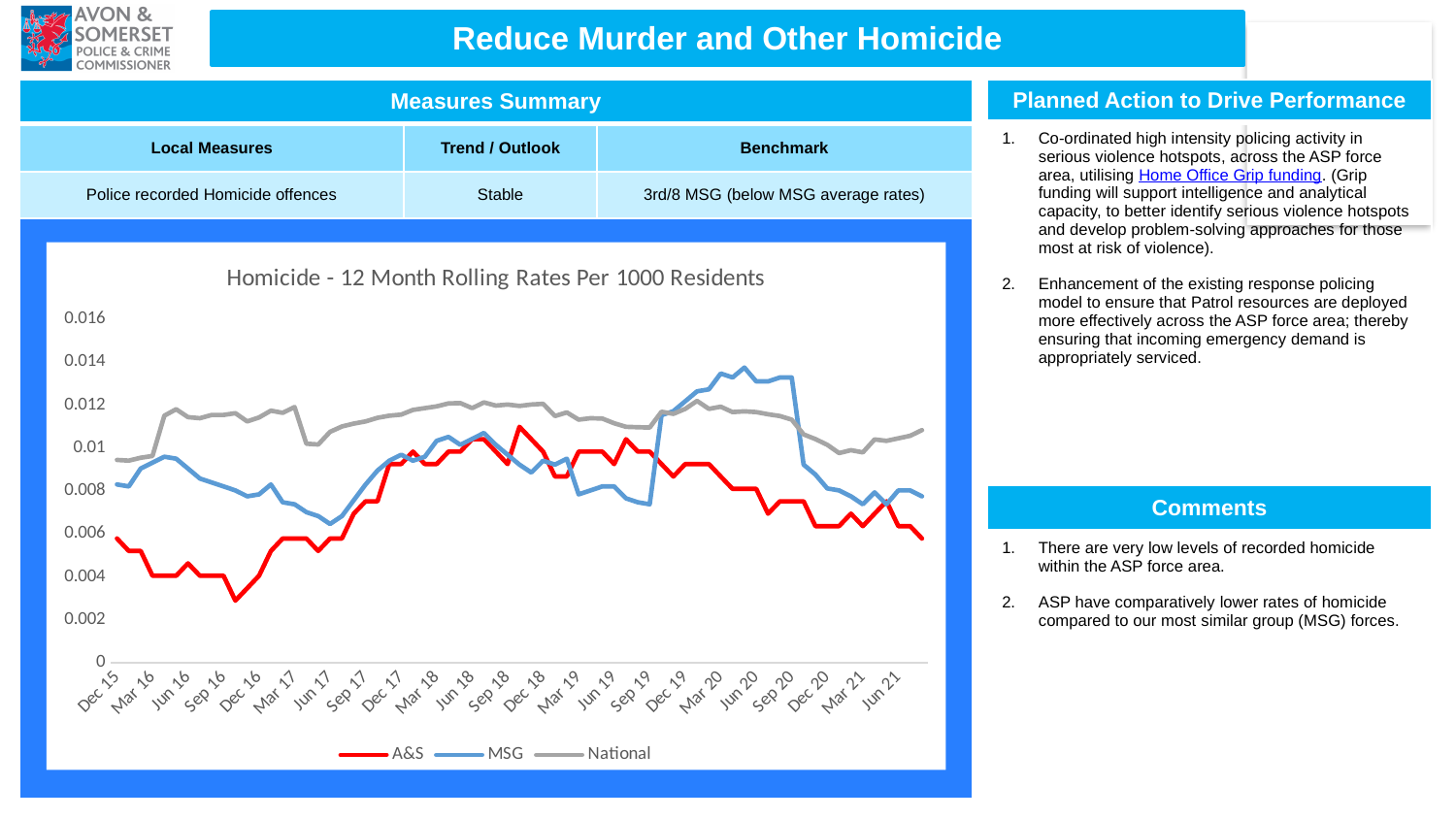
At Jun 20, which is larger, the MSG value or the National value? MSG At Dec 15, which is larger, the MSG value or the A&S value? MSG How many series does the chart legend list? 3 What is the title of the chart? Homicide - 12 Month Rolling Rates Per 1000 Residents What kind of chart is shown on the slide? Line chart Does the A&S line rise or fall between Sep 16 and Sep 18? Rise Is the MSG value at Jun 20 greater or less than 0.012? greater Does the MSG line rise or fall between Jun 20 and Jun 21? Fall Which series is drawn in red in the chart? A&S Is the National value at Dec 15 greater or less than 0.008? greater Which series has the lowest value at Dec 15? A&S